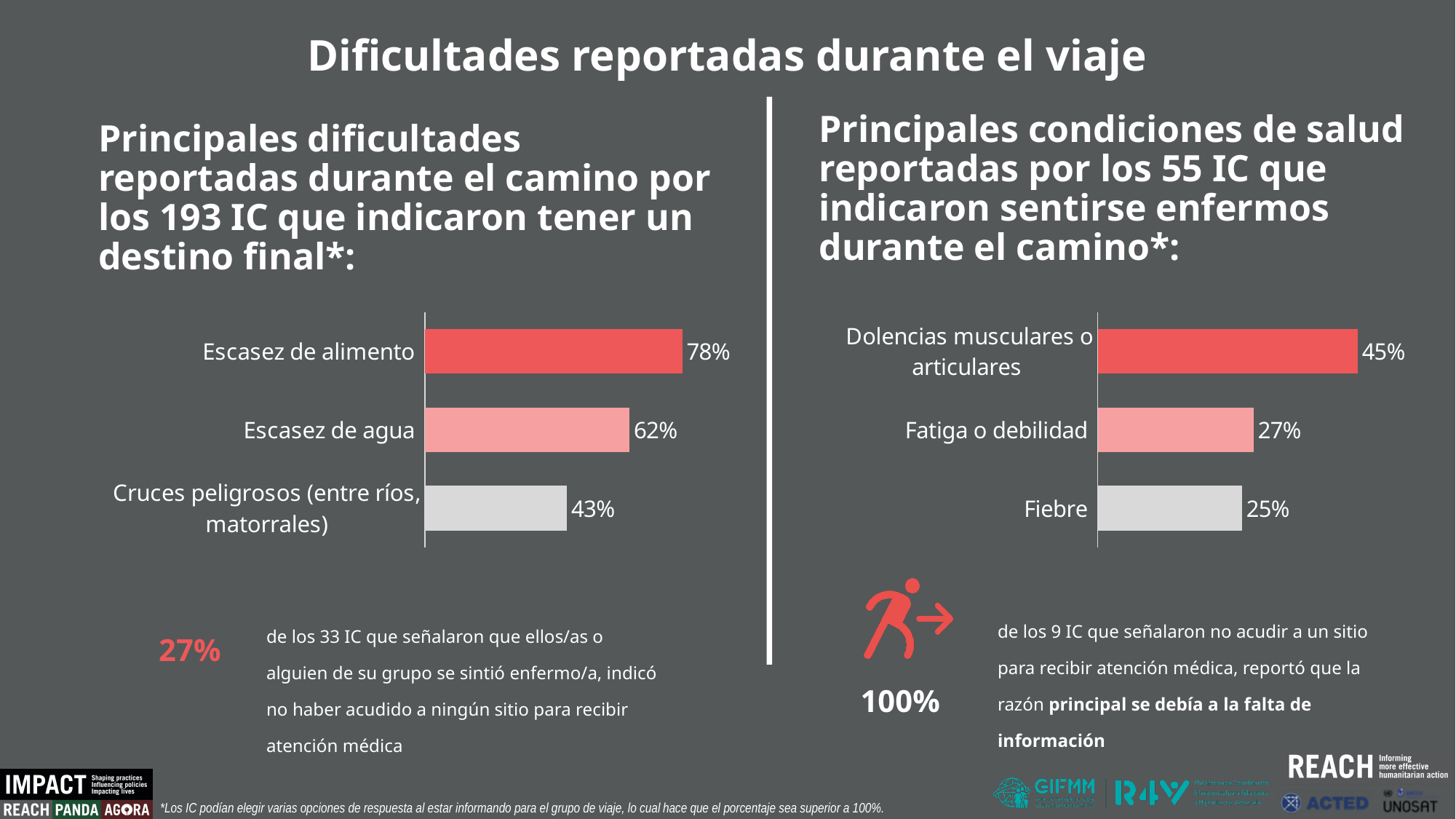
In the left chart (Principales dificultades reportadas durante el camino), which is larger: Escasez de agua or Cruces peligrosos (entre ríos, matorrales)? Escasez de agua In the left chart (Principales dificultades reportadas durante el camino), what is the difference between Escasez de alimento and Escasez de agua? 16% What is the main title of the slide? Dificultades reportadas durante el viaje What kind of chart is the left chart (Principales dificultades reportadas durante el camino)? Bar chart In the right chart (Principales condiciones de salud), what is the value for Dolencias musculares o articulares? 45% In the right chart (Principales condiciones de salud), what is the difference between Dolencias musculares o articulares and Fiebre? 20% How many categories are shown in the right chart (Principales condiciones de salud)? 3 In the left chart (Principales dificultades reportadas durante el camino), what is the value for Cruces peligrosos (entre ríos, matorrales)? 43% In the left chart (Principales dificultades reportadas durante el camino), what is the value for Escasez de alimento? 78% In the left chart (Principales dificultades reportadas durante el camino), which category has the highest value? Escasez de alimento In the right chart (Principales condiciones de salud), which category has the lowest value? Fiebre In the right chart (Principales condiciones de salud), what is the value for Fatiga o debilidad? 27%